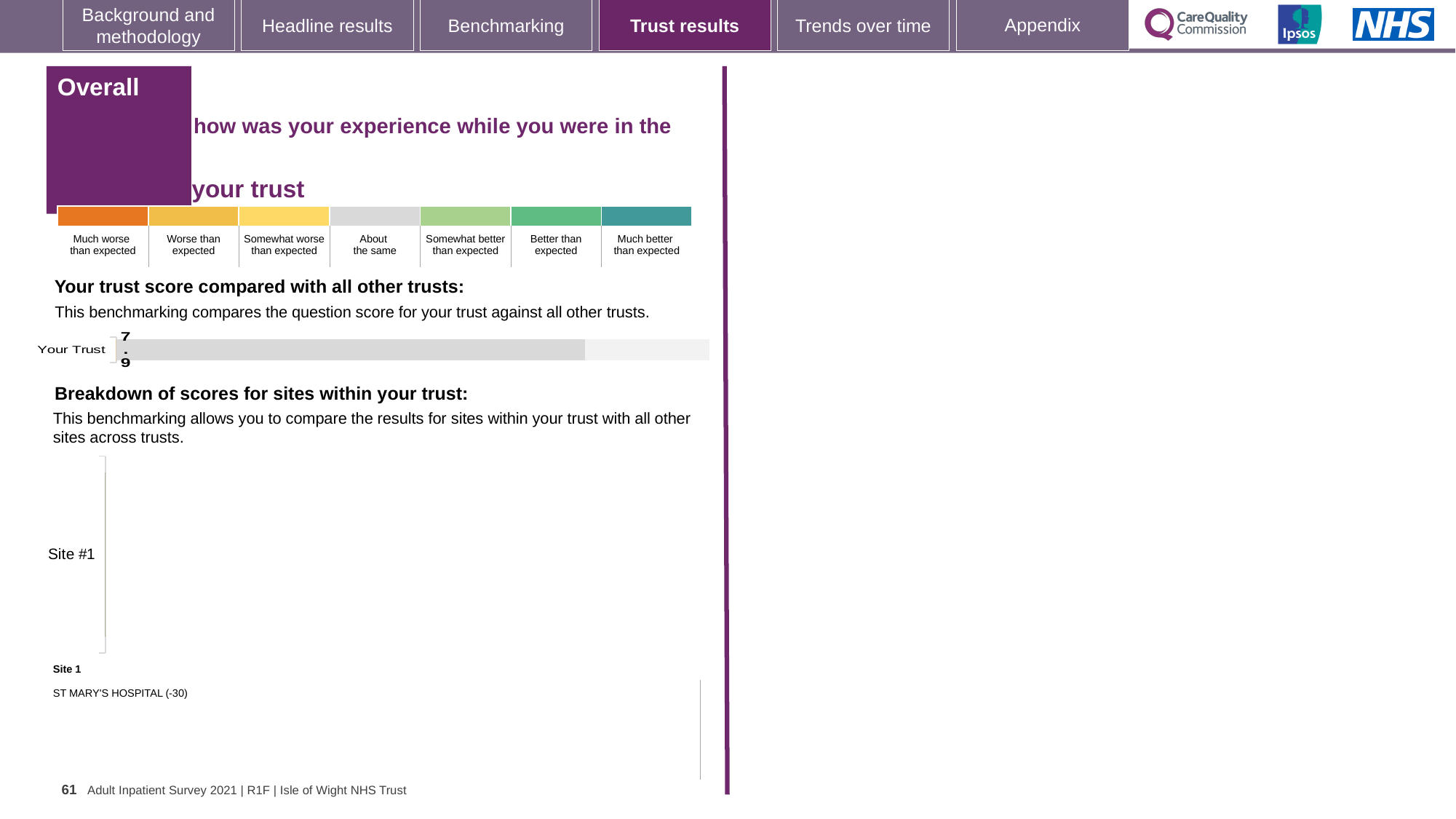
Is the value for Your Trust in the chart under 'Your trust score compared with all other trusts' greater or less than 10? less What kind of chart is used under 'Your trust score compared with all other trusts'? bar chart What is the label of the single category plotted in the chart under 'Your trust score compared with all other trusts'? Your Trust How many categories are plotted in the chart under 'Your trust score compared with all other trusts'? 1 Is the value for Your Trust in the chart under 'Your trust score compared with all other trusts' greater or less than 5? greater In the chart under 'Your trust score compared with all other trusts', what is the value shown for Your Trust? 7.9 What colour is the bar for Your Trust in the chart under 'Your trust score compared with all other trusts'? grey